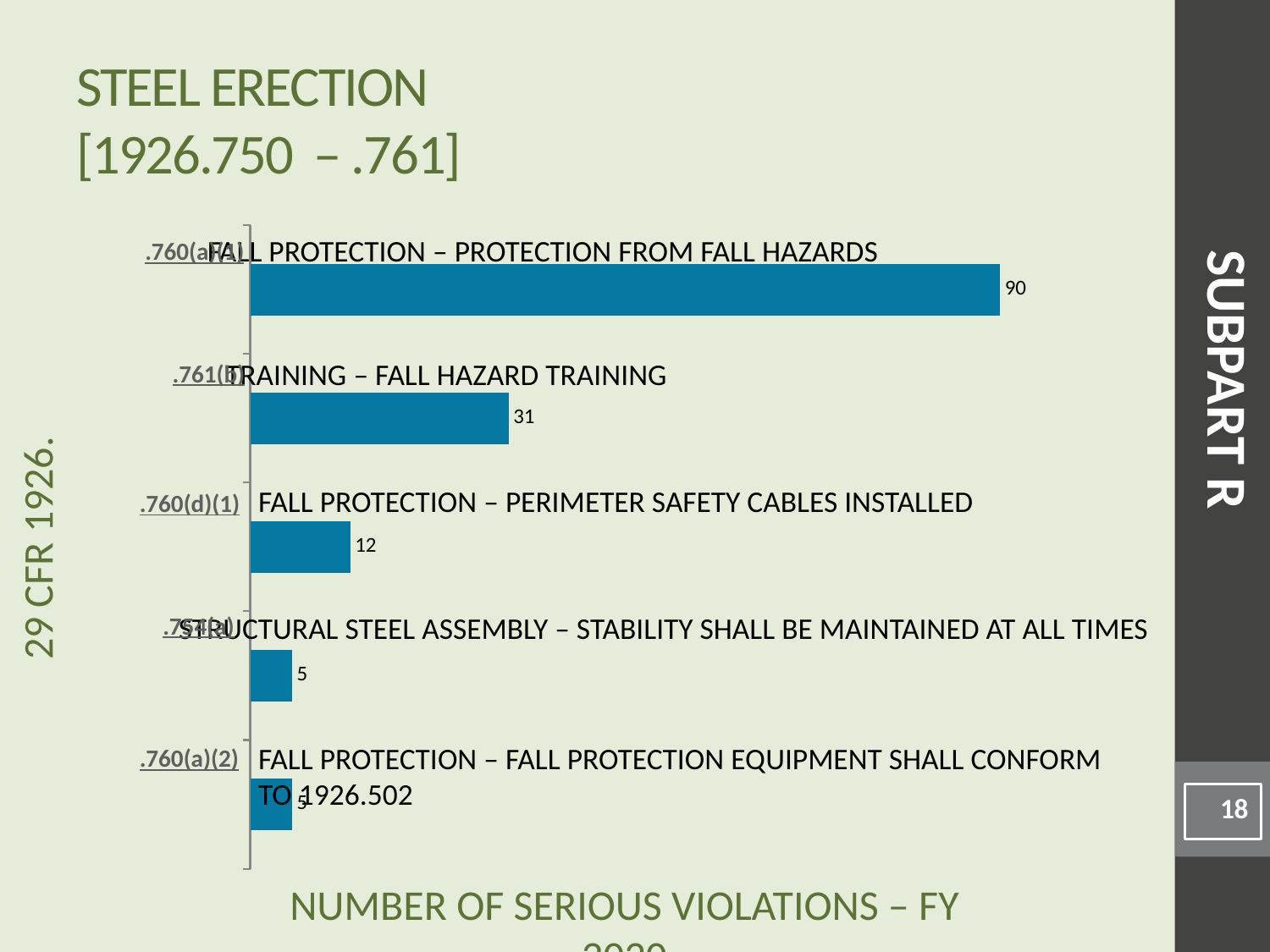
What is the difference between the violations for TRAINING – FALL HAZARD TRAINING and PERIMETER SAFETY CABLES INSTALLED? 19 Which category has the highest number of serious violations? FALL PROTECTION – PROTECTION FROM FALL HAZARDS What is the number of serious violations for FALL PROTECTION – PROTECTION FROM FALL HAZARDS (.760(a)(1))? 90 Which has more serious violations: .760(d)(1) PERIMETER SAFETY CABLES INSTALLED or .760(a)(2) FALL PROTECTION EQUIPMENT SHALL CONFORM TO 1926.502? .760(d)(1) PERIMETER SAFETY CABLES INSTALLED What is the number of serious violations for STRUCTURAL STEEL ASSEMBLY – STABILITY SHALL BE MAINTAINED AT ALL TIMES? 5 What is the difference between the violations for PROTECTION FROM FALL HAZARDS and TRAINING – FALL HAZARD TRAINING? 59 What is the difference between the violations for PROTECTION FROM FALL HAZARDS and PERIMETER SAFETY CABLES INSTALLED? 78 How many categories (bars) are shown in the chart? 5 What is the number of serious violations for FALL PROTECTION – PERIMETER SAFETY CABLES INSTALLED (.760(d)(1))? 12 What is the number of serious violations for TRAINING – FALL HAZARD TRAINING (.761(b))? 31 Which has more serious violations: TRAINING – FALL HAZARD TRAINING or FALL PROTECTION – PERIMETER SAFETY CABLES INSTALLED? TRAINING – FALL HAZARD TRAINING What kind of chart is shown on the slide? Bar chart